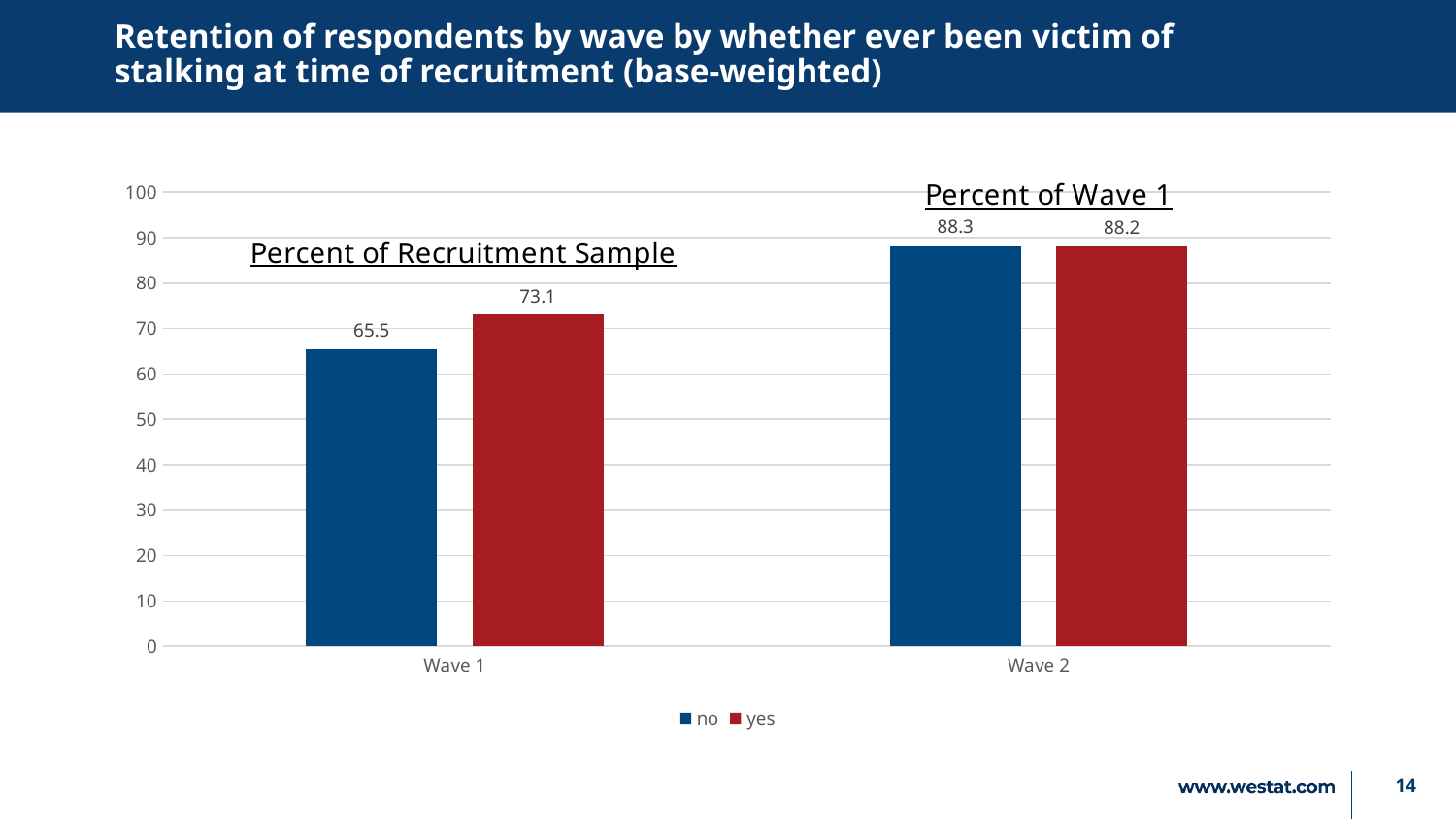
How many series does the legend list? 2 What is the value for 'no' in Wave 2? 88.3 What is the value for 'yes' in Wave 1? 73.1 How many categories are shown on the x axis? 2 What is the value for 'yes' in Wave 2? 88.2 What colour are the bars for the 'yes' series? red What is the difference between the 'yes' and 'no' values in Wave 1? 7.6 Is the value for 'no' in Wave 1 greater or less than 70? less Does the 'no' series rise or fall from Wave 1 to Wave 2? rise What kind of chart is shown on the slide? bar chart What is the value for 'no' in Wave 1? 65.5 Which is larger in Wave 1, the 'no' value or the 'yes' value? yes